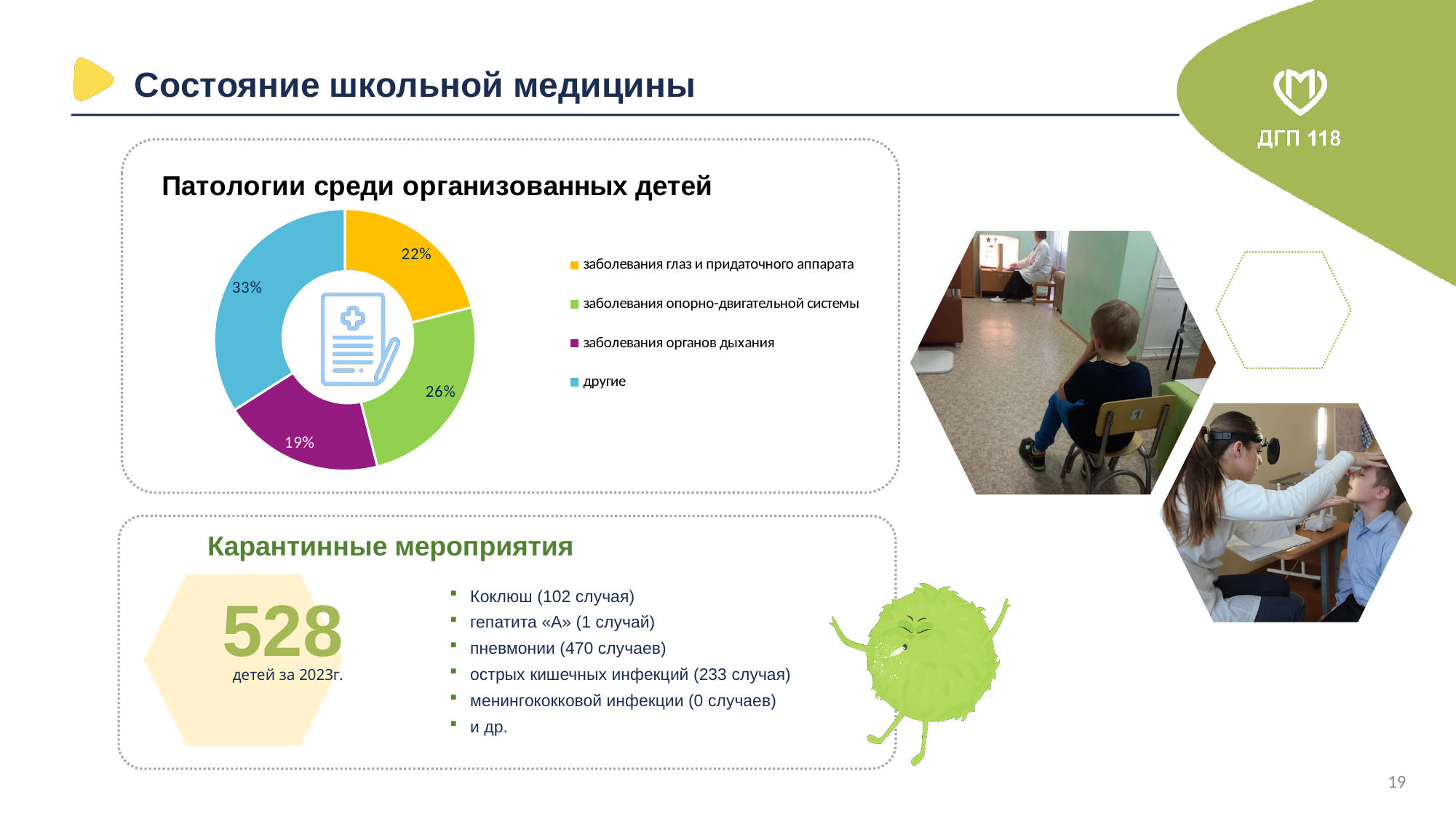
Which is larger: the share for "заболевания опорно-двигательной системы" or for "заболевания глаз и придаточного аппарата"? заболевания опорно-двигательной системы What share of the pie chart is "заболевания глаз и придаточного аппарата"? 22% How many categories does the pie chart show? 4 What type of chart is shown under the heading "Патологии среди организованных детей"? Pie chart (donut) What share of the pie chart is "другие"? 33% Which category has the smallest share in the pie chart? заболевания органов дыхания What colour is the slice for "заболевания органов дыхания"? Purple Which category has the largest share in the pie chart? другие What is the title of the pie chart? Патологии среди организованных детей What is the difference in percentage points between "другие" and "заболевания органов дыхания"? 14 What share of the pie chart is "заболевания опорно-двигательной системы"? 26% What share of the pie chart is "заболевания органов дыхания"? 19%